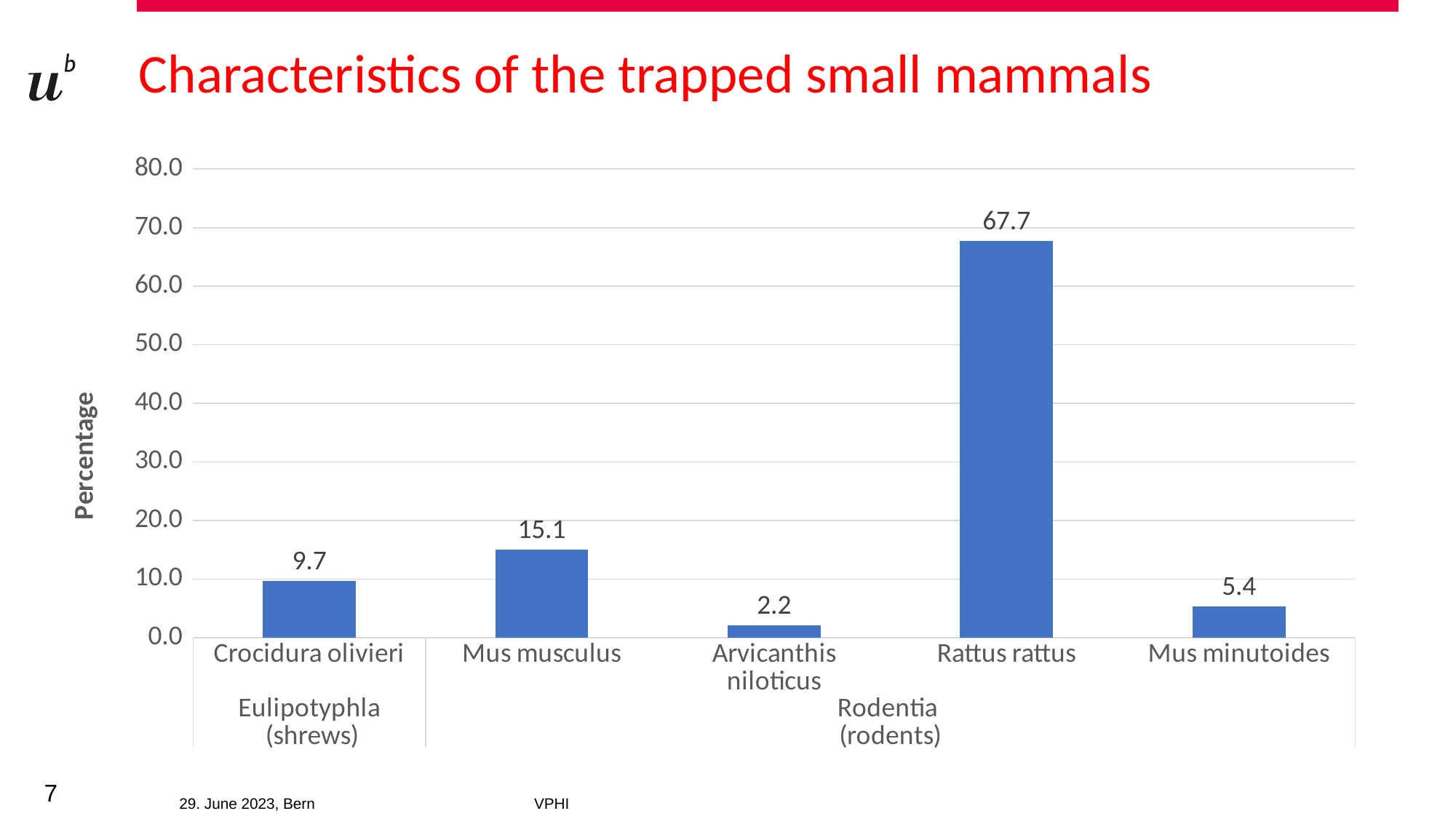
What is the difference in percentage between Mus musculus and Crocidura olivieri? 5.4 What is the percentage for Mus minutoides? 5.4 Which species has the lowest percentage? Arvicanthis niloticus What is the percentage for Arvicanthis niloticus? 2.2 What is the label of the vertical axis? Percentage What is the difference in percentage between Rattus rattus and Mus musculus? 52.6 Which species has the highest percentage? Rattus rattus How many species are shown on the chart? 5 Which has a larger percentage, Mus musculus or Mus minutoides? Mus musculus What kind of chart is shown on the slide? Bar chart What is the percentage for Crocidura olivieri? 9.7 What is the percentage for Rattus rattus? 67.7